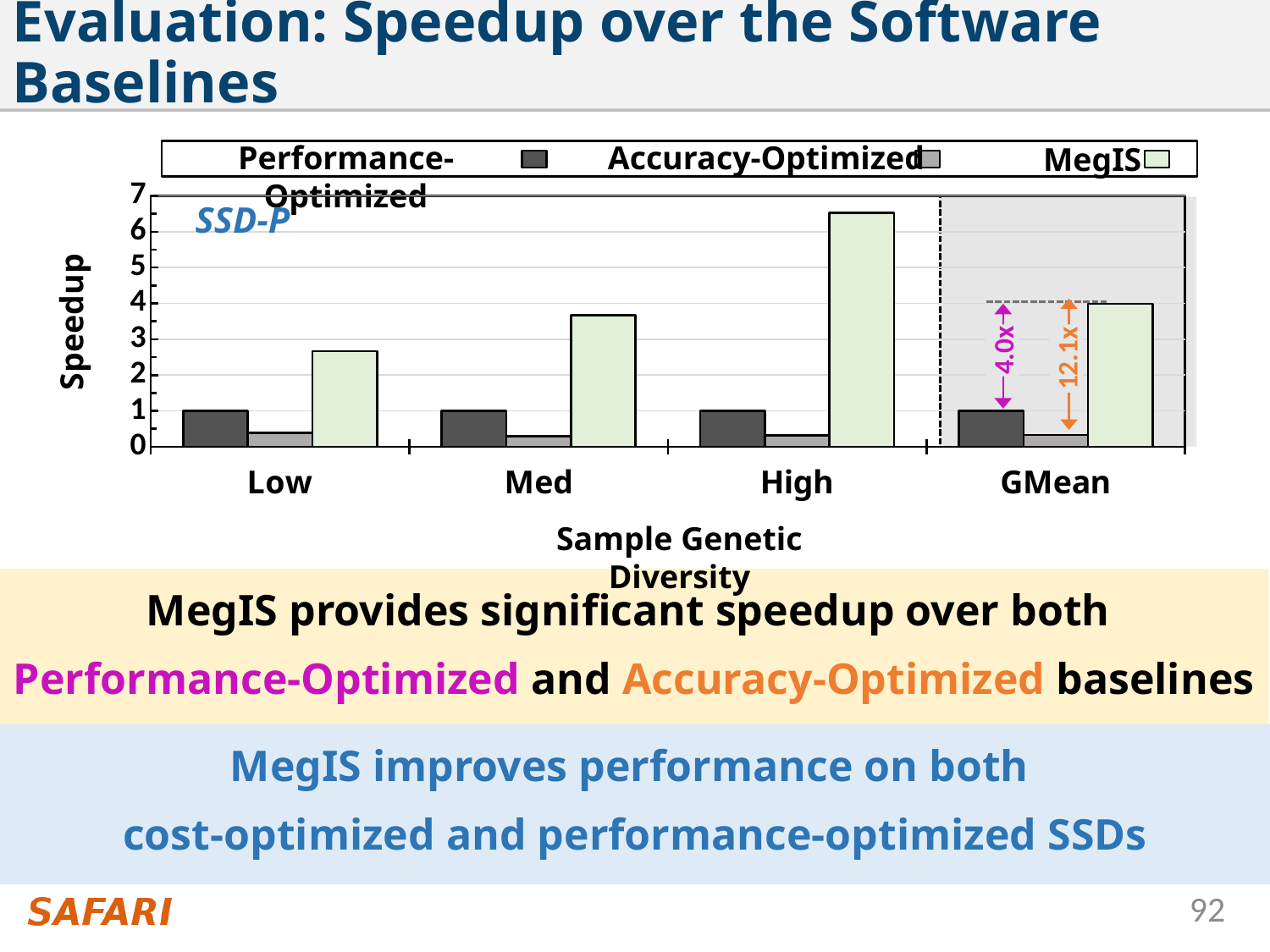
How many categories are shown on the x axis? 4 For High, which is larger: the MegIS speedup or the Accuracy-Optimized speedup? MegIS What is the MegIS speedup for GMean? 4 How many series does the legend list? 3 Which category has the highest MegIS speedup? High What is the label of the y axis? Speedup What kind of chart is shown on the slide? bar chart What is the speedup of Performance-Optimized for Low? 1 Is the MegIS speedup for Low greater or less than 3? less Which category has the lowest MegIS speedup? Low Is the MegIS speedup for High greater or less than 6? greater Do the MegIS speedups rise or fall from Low to High? rise